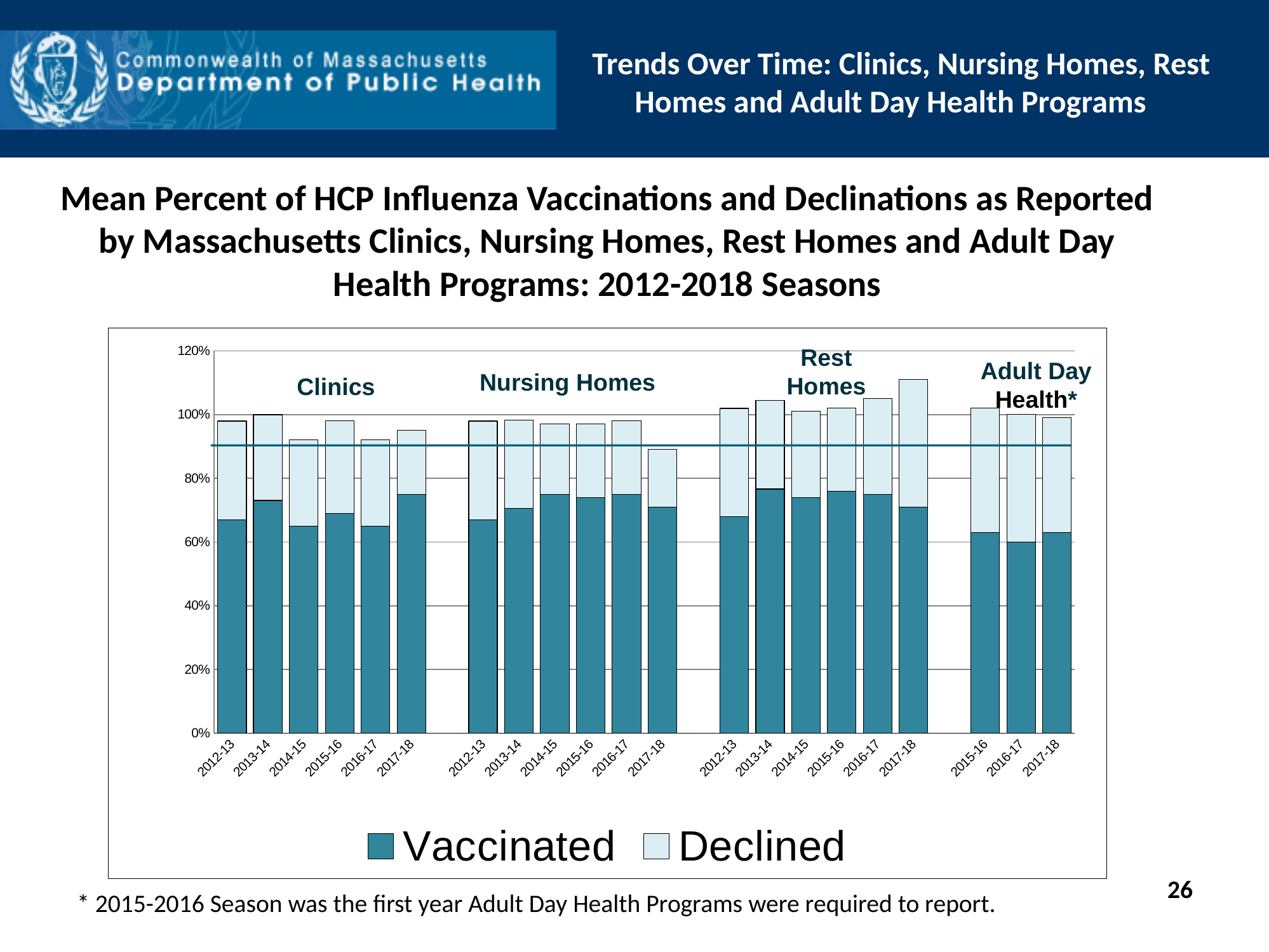
What kind of chart is shown on the slide? stacked bar chart How many seasons are plotted for the Clinics group? 6 How many facility type groups are shown in the chart? 4 Within the Rest Homes group, which season has the tallest stacked bar? 2017-18 What are the two series named in the legend? Vaccinated and Declined How many series does the chart legend list? 2 Is the total stacked bar for Rest Homes in 2017-18 greater or less than 100%? greater Is the total stacked bar for Nursing Homes in 2017-18 greater or less than 100%? less Within the Nursing Homes group, which season has the shortest stacked bar? 2017-18 Is the Vaccinated value for Clinics in 2013-14 greater or less than 60%? greater How many seasons are plotted for the Adult Day Health group? 3 Which is larger: the Vaccinated value for Clinics in 2013-14 or for Clinics in 2012-13? Clinics 2013-14